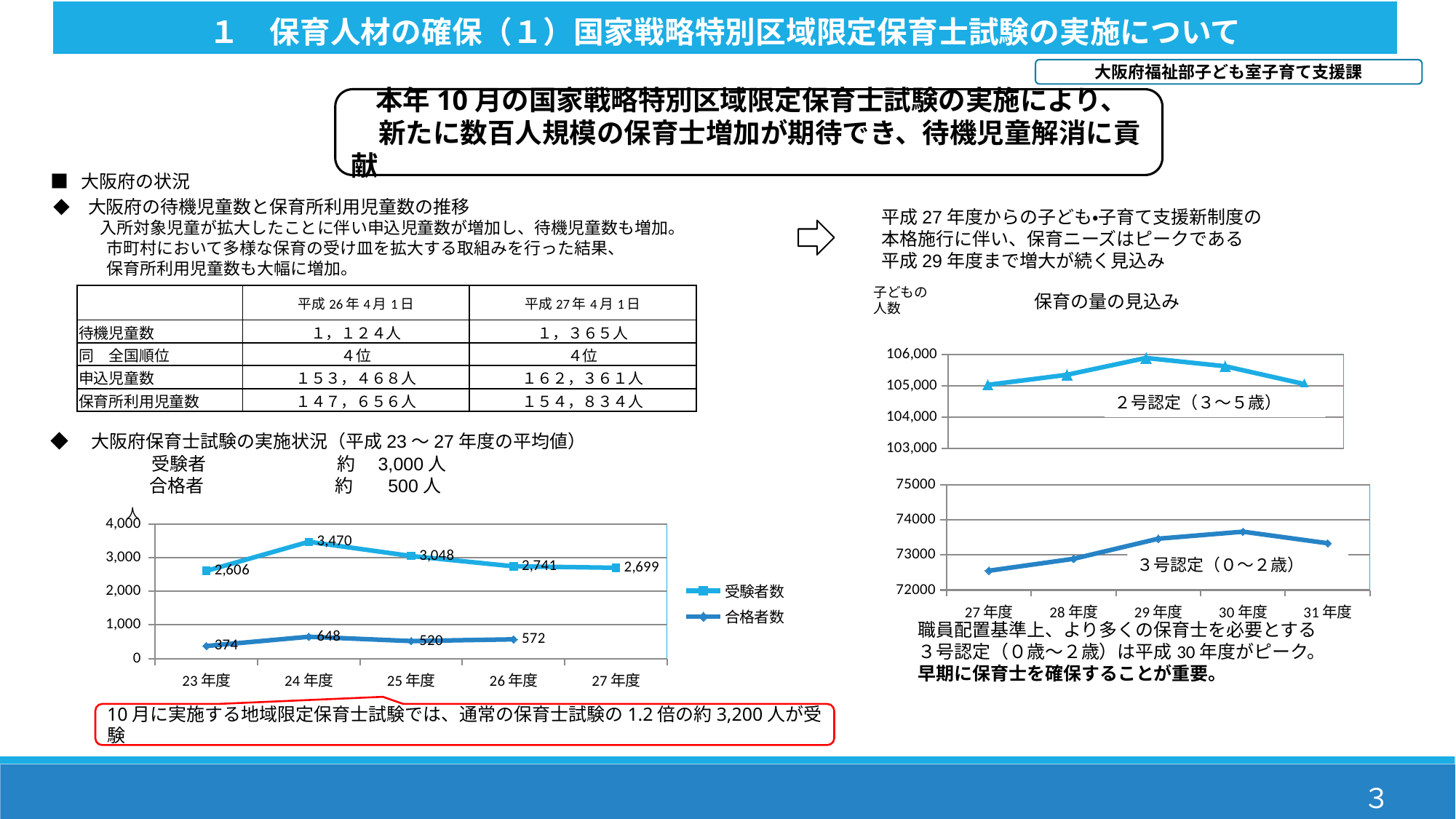
In the bottom-left line chart, what is the value of 合格者数 for 23年度? 374 In the 保育の量の見込み chart on the right, in which year does the ２号認定（３～５歳） line reach its peak? 29年度 In the bottom-left line chart, what is the difference between 受験者数 in 24年度 and 25年度? 422 In the bottom-left line chart, how many years are shown on the x axis? 5 In the bottom-left line chart, how many series does the legend list? 2 In the 保育の量の見込み chart on the right, in which year does the ３号認定（０～２歳） line reach its peak? 30年度 In the bottom-left line chart, which year has the lowest 合格者数? 23年度 In the bottom-left line chart of 大阪府保育士試験の実施状況, what is the value of 受験者数 for 24年度? 3,470 What kind of chart is the 保育の量の見込み chart on the right side of the slide? line chart In the 保育の量の見込み chart on the right, is the value of ３号認定（０～２歳） for 27年度 greater or less than 73000? less In the bottom-left line chart, which year has the highest 受験者数? 24年度 In the bottom-left line chart, which is larger: 合格者数 in 25年度 or 26年度? 26年度